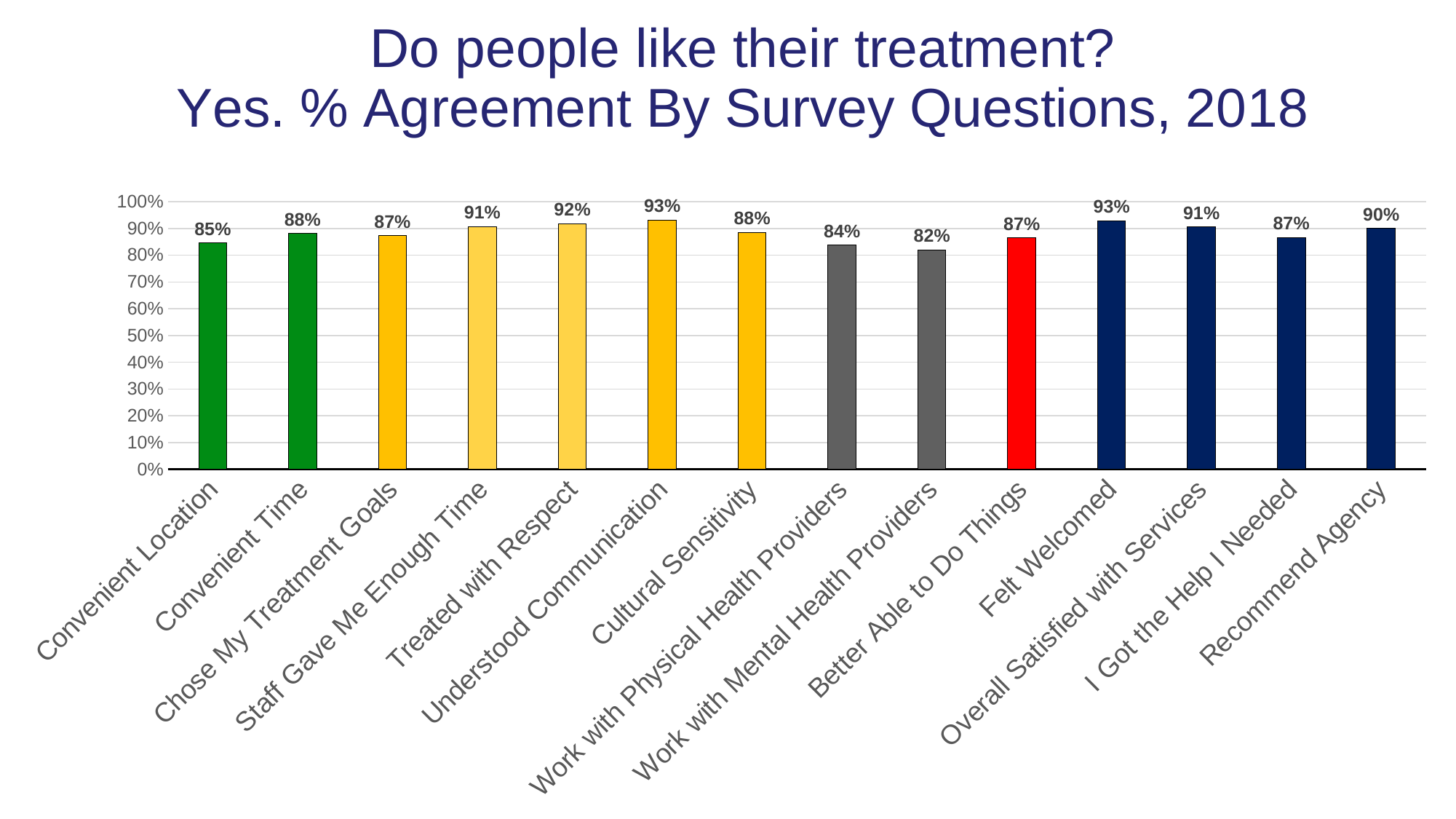
What type of chart is shown on the slide? Bar chart How many survey questions are shown on the x axis? 14 What is the difference in % agreement between Understood Communication and Work with Mental Health Providers? 11% Which survey question has the lowest % agreement? Work with Mental Health Providers Which has a higher % agreement, Staff Gave Me Enough Time or I Got the Help I Needed? Staff Gave Me Enough Time Which has a higher % agreement, Convenient Time or Cultural Sensitivity? They are equal (88%) What is the % agreement for Convenient Location? 85% What is the difference in % agreement between Felt Welcomed and Better Able to Do Things? 6% What is the % agreement for Treated with Respect? 92% What is the % agreement for Work with Physical Health Providers? 84% What is the % agreement for Recommend Agency? 90% Is the value for Overall Satisfied with Services greater or less than 90%? greater